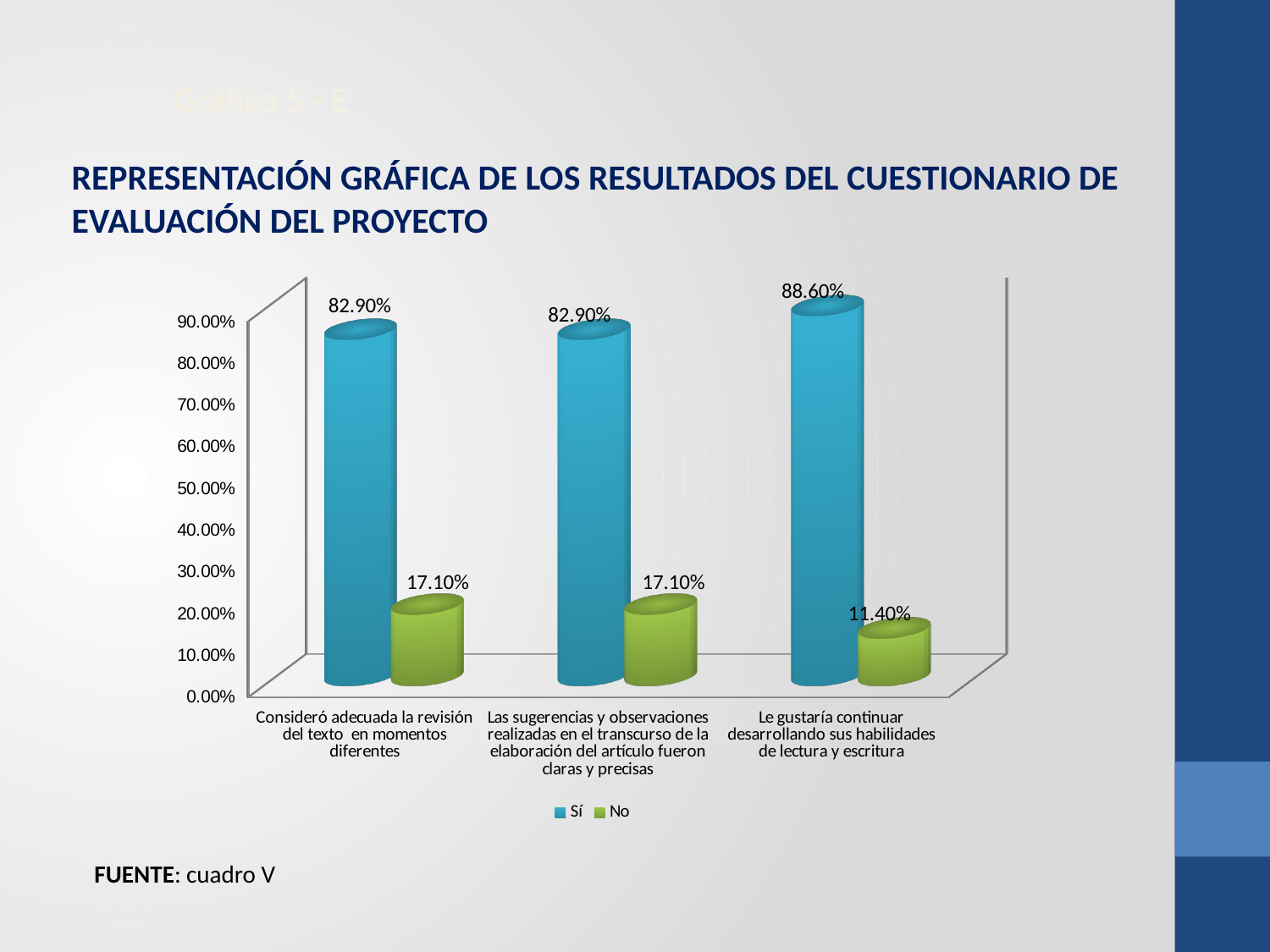
What is the 'Sí' value for 'Le gustaría continuar desarrollando sus habilidades de lectura y escritura'? 88.60% What kind of chart is shown on the slide? Bar chart How many series does the legend list? 2 Which category has the highest 'Sí' value? Le gustaría continuar desarrollando sus habilidades de lectura y escritura Which is larger: the 'Sí' value for 'Consideró adecuada la revisión del texto en momentos diferentes' or the 'Sí' value for 'Le gustaría continuar desarrollando sus habilidades de lectura y escritura'? Le gustaría continuar desarrollando sus habilidades de lectura y escritura What is the difference between the 'No' value for 'Consideró adecuada la revisión del texto en momentos diferentes' and the 'No' value for 'Le gustaría continuar desarrollando sus habilidades de lectura y escritura'? 5.70% Which category has the lowest 'No' value? Le gustaría continuar desarrollando sus habilidades de lectura y escritura What is the 'No' value for 'Le gustaría continuar desarrollando sus habilidades de lectura y escritura'? 11.40% What is the 'Sí' value for 'Las sugerencias y observaciones realizadas en el transcurso de la elaboración del artículo fueron claras y precisas'? 82.90% How many categories are shown on the x axis? 3 What is the difference between the 'Sí' and 'No' values for 'Le gustaría continuar desarrollando sus habilidades de lectura y escritura'? 77.20% What is the 'No' value for 'Consideró adecuada la revisión del texto en momentos diferentes'? 17.10%